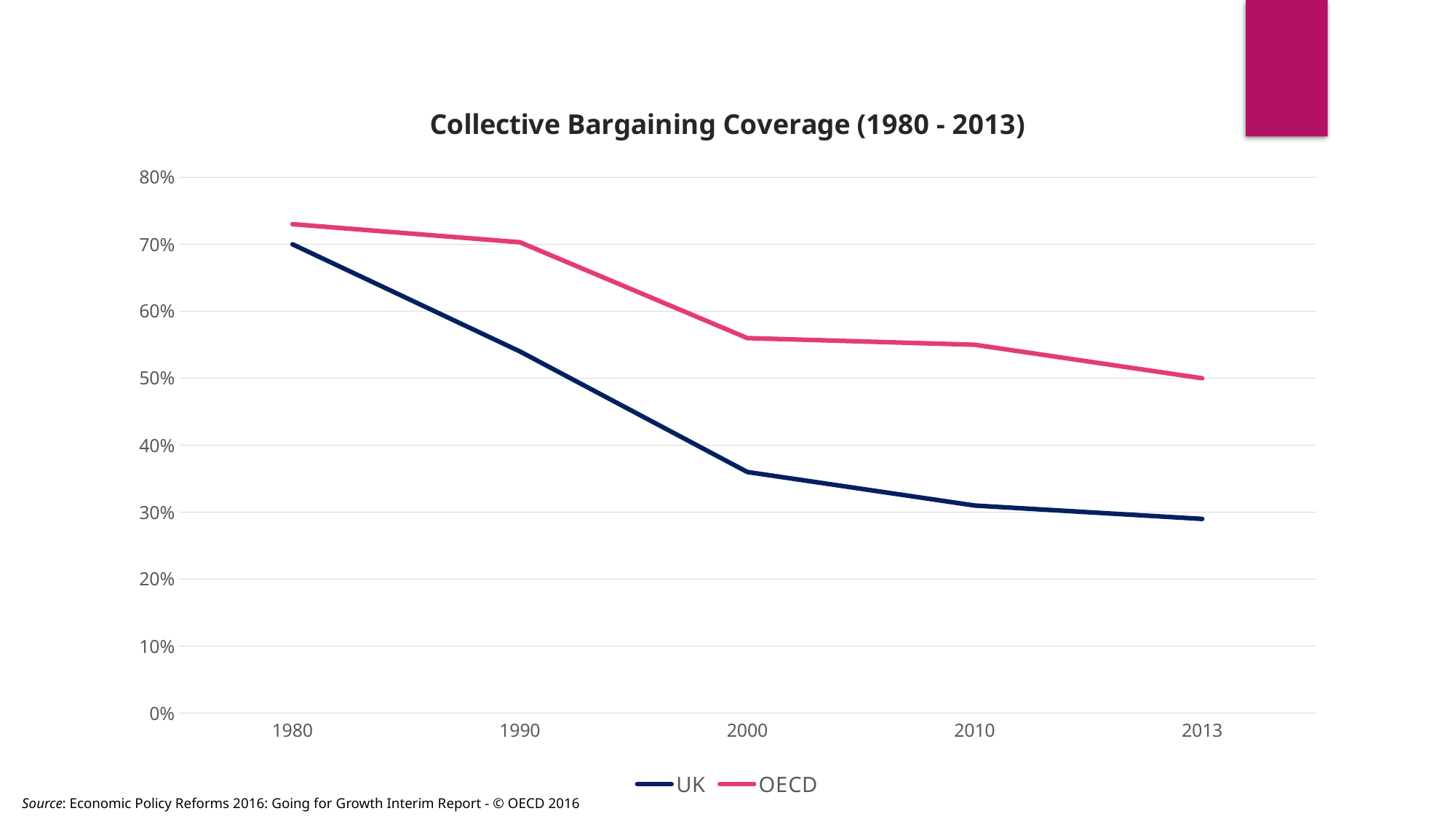
What is the OECD value in 2013? 50% Is the UK value in 2000 greater or less than 40%? less What is the title of the chart? Collective Bargaining Coverage (1980 - 2013) How many series does the legend list? 2 In 2010, which series has the higher value, UK or OECD? OECD Does the UK series rise or fall from 1980 to 2013? fall In which year is the UK value highest? 1980 What kind of chart is shown on the slide? line chart What is the UK value in 1980? 70% Does the OECD series rise or fall from 1980 to 2013? fall Is the OECD value in 2000 greater or less than 50%? greater How many years are plotted along the x axis? 5